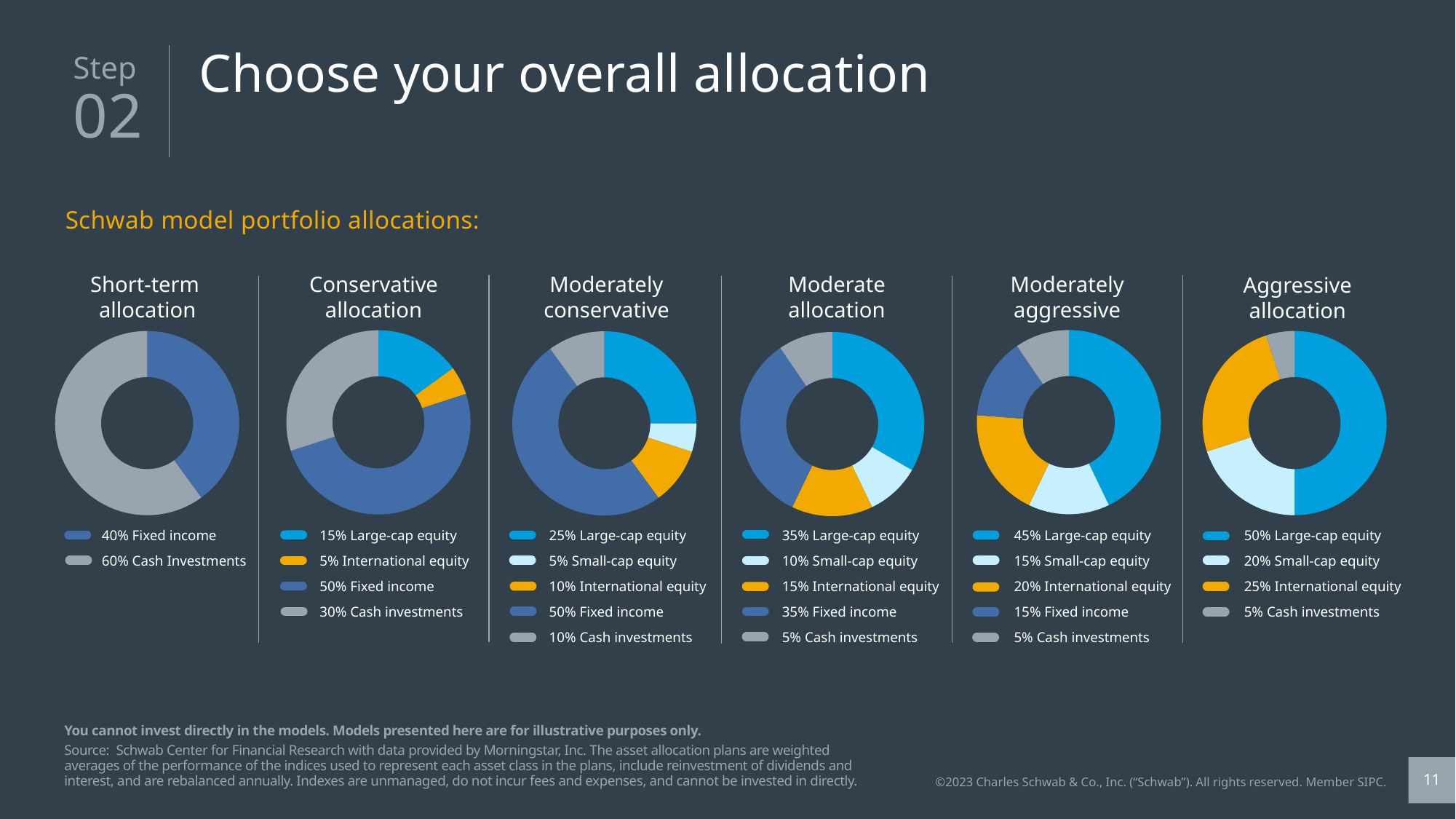
How many categories does the Moderately conservative chart show? 5 How many charts are shown on the slide? 6 In the Moderately conservative chart, what share is International equity? 10% In the Conservative allocation chart, what share is Fixed income? 50% In the Aggressive allocation chart, which category has the largest share? Large-cap equity In the Moderate allocation chart, which is larger: International equity or Small-cap equity? International equity In the Short-term allocation chart, what share is Cash Investments? 60% In the Moderately aggressive chart, what is the difference between Large-cap equity and Fixed income? 30% What kind of chart is used for the Conservative allocation? Doughnut chart In the Moderately aggressive chart, which category has the smallest share? Cash investments In the Moderate allocation chart, what share is Small-cap equity? 10% How many categories does the Short-term allocation chart show? 2